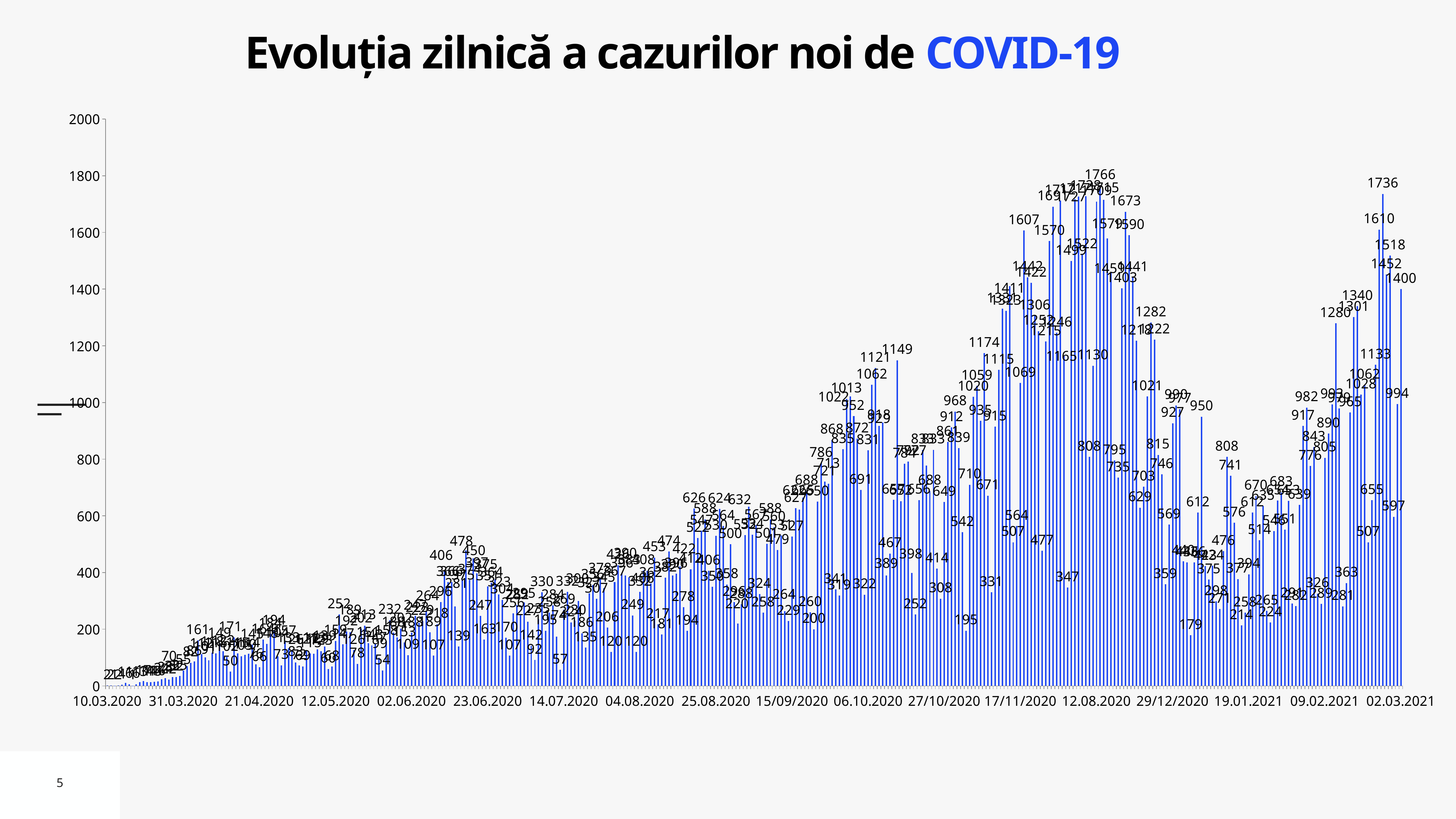
Is the value of the tallest bar greater or less than 1800? less Overall, do the daily values rise or fall from March 2020 to March 2021? rise What is the first date label on the x axis? 10.03.2020 How many date labels are shown on the x axis? 18 What is the value of the tallest bar in the chart? 1766 Is the highest value reached in June 2020 greater or less than 500? less What kind of chart is shown on the slide? bar chart What is the title of the chart? Evoluția zilnică a cazurilor noi de COVID-19 Which is larger, the peak value in December 2020 (1766) or the peak value in February 2021 (1736)? 1766 What is the maximum value shown on the y axis? 2000 What is the value of the tallest bar in 2021 (the peak near the right end of the chart)? 1736 What is the difference between the overall peak value (1766) and the 2021 peak value (1736)? 30